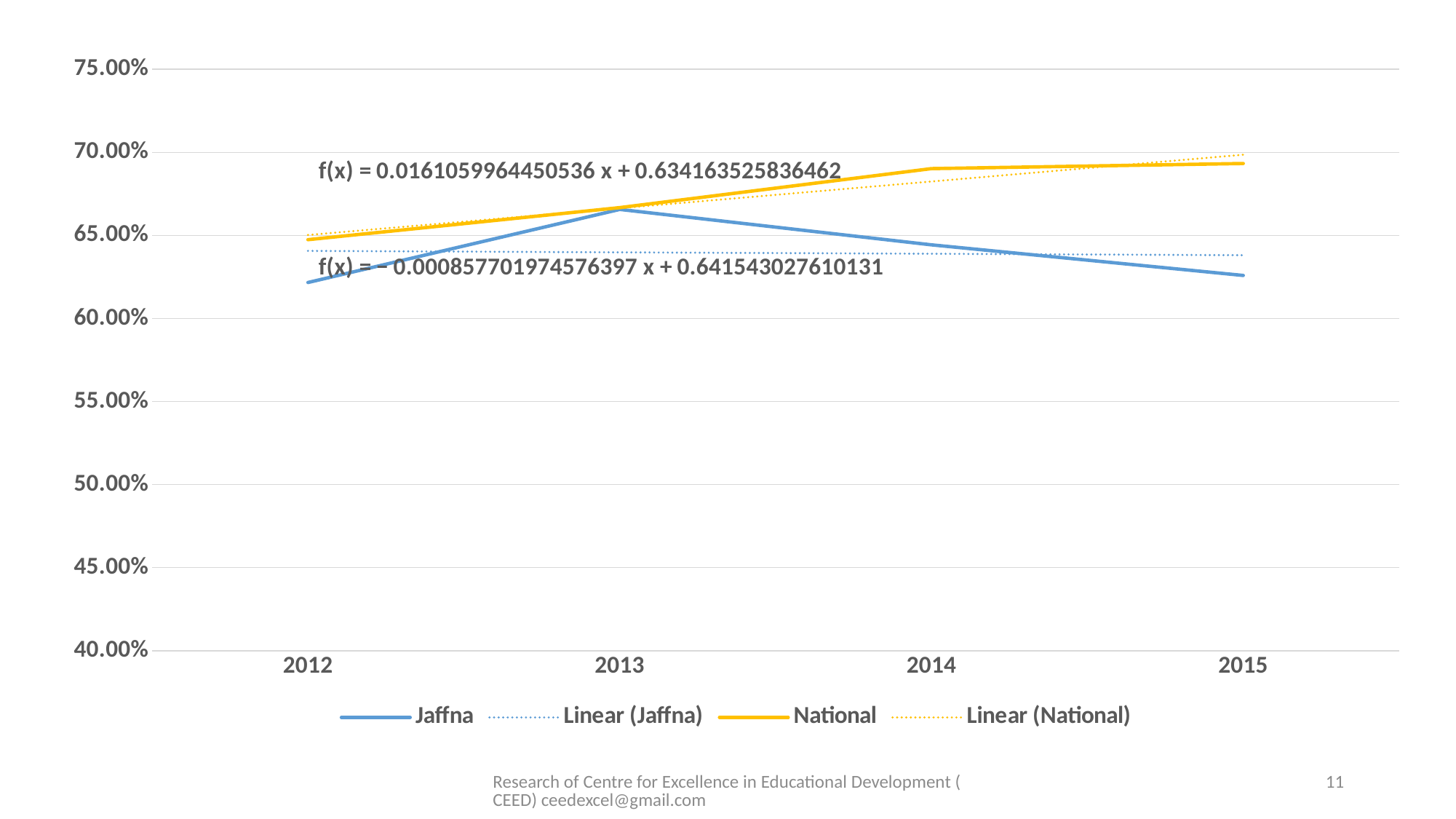
What kind of chart is shown on the slide? line chart What is the trendline equation shown for the National series? f(x) = 0.0161059964450536 x + 0.634163525836462 In 2015, which is larger: the Jaffna value or the National value? National Is the National value for 2014 greater or less than 70.00%? less In 2012, which is larger: the Jaffna value or the National value? National Is the Jaffna value for 2012 greater or less than 60.00%? greater In which year does the Jaffna series reach its highest value? 2013 What colour is the line for the National series? yellow How many years are plotted along the x axis? 4 Does the National series rise or fall from 2012 to 2015? rise How many entries does the legend list? 4 Is the Jaffna value for 2013 greater or less than 65.00%? greater